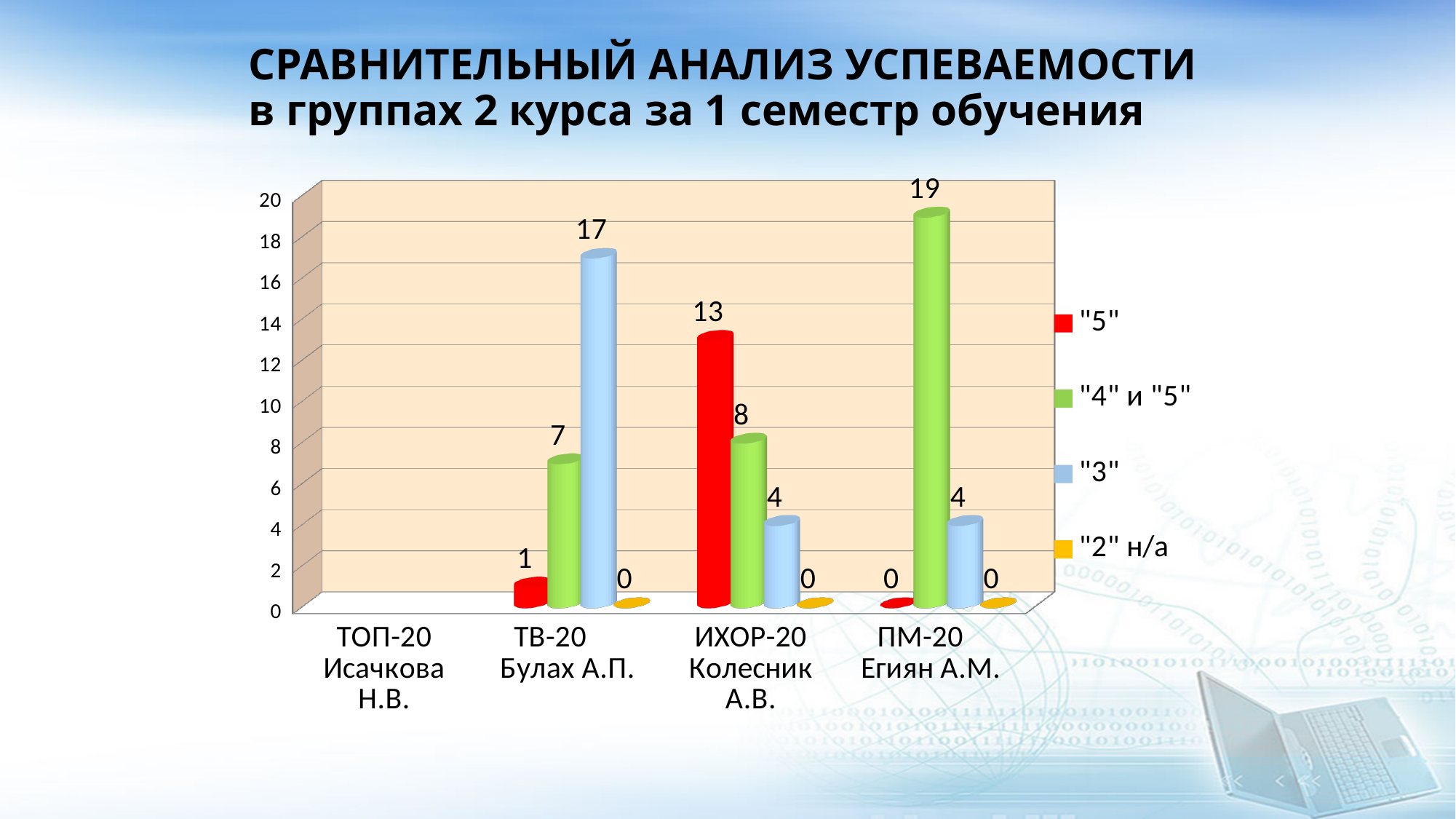
What is the value of the "5" series for ИХОР-20 Колесник А.В.? 13 How many categories are shown on the x axis? 4 What is the value of the "4" и "5" series for ПМ-20 Егиян А.М.? 19 How many series does the legend list? 4 What is the difference between the "5" value for ИХОР-20 Колесник А.В. and the "5" value for ТВ-20 Булах А.П.? 12 What is the value of the "3" series for ТВ-20 Булах А.П.? 17 Which category has the highest value in the "4" и "5" series? ПМ-20 Егиян А.М. What colour are the bars for the "2" н/а series? yellow Which category has the highest value in the "3" series? ТВ-20 Булах А.П. What is the value of the "5" series for ТВ-20 Булах А.П.? 1 What type of chart is shown on the slide? bar chart Which is larger: the "4" и "5" value for ИХОР-20 Колесник А.В. or the "4" и "5" value for ТВ-20 Булах А.П.? ИХОР-20 Колесник А.В.